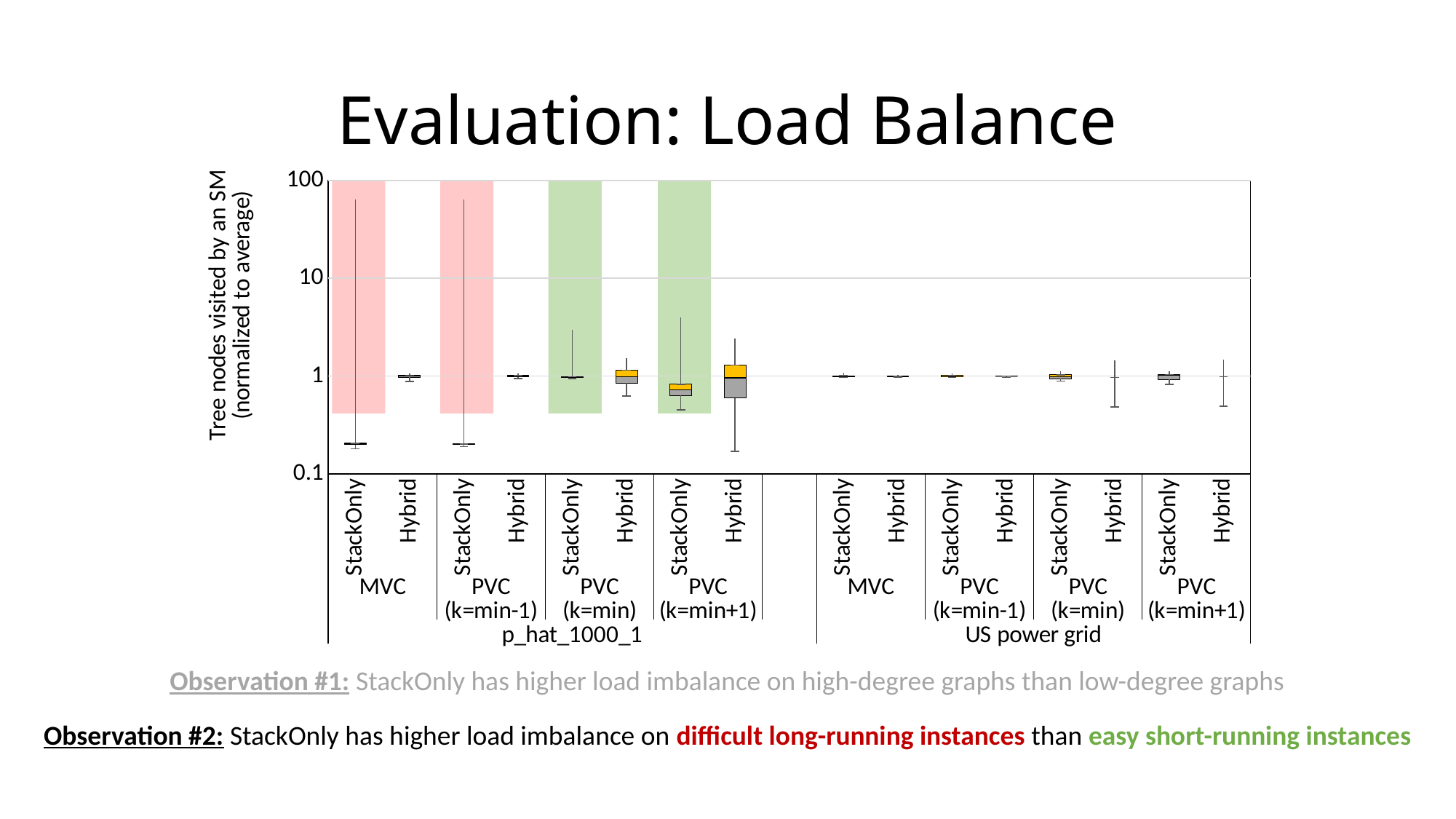
How many graph datasets are shown along the x axis? 2 What kind of chart is shown on the slide? Box plot Is the maximum value for StackOnly on PVC (k=min-1) for p_hat_1000_1 greater or less than 10? greater How many boxes (StackOnly/Hybrid pairs across all problem types) are plotted in total? 16 Is the maximum value for StackOnly on MVC for p_hat_1000_1 greater or less than 10? greater Is the maximum value for StackOnly on PVC (k=min) for p_hat_1000_1 greater or less than 10? less What is the highest tick value shown on the y axis? 100 Which has the larger maximum value: StackOnly on PVC (k=min+1) for p_hat_1000_1 or StackOnly on PVC (k=min+1) for US power grid? StackOnly on PVC (k=min+1) for p_hat_1000_1 Which has the larger maximum value: StackOnly on MVC for p_hat_1000_1 or StackOnly on MVC for US power grid? StackOnly on MVC for p_hat_1000_1 What is the label of the y axis? Tree nodes visited by an SM (normalized to average)